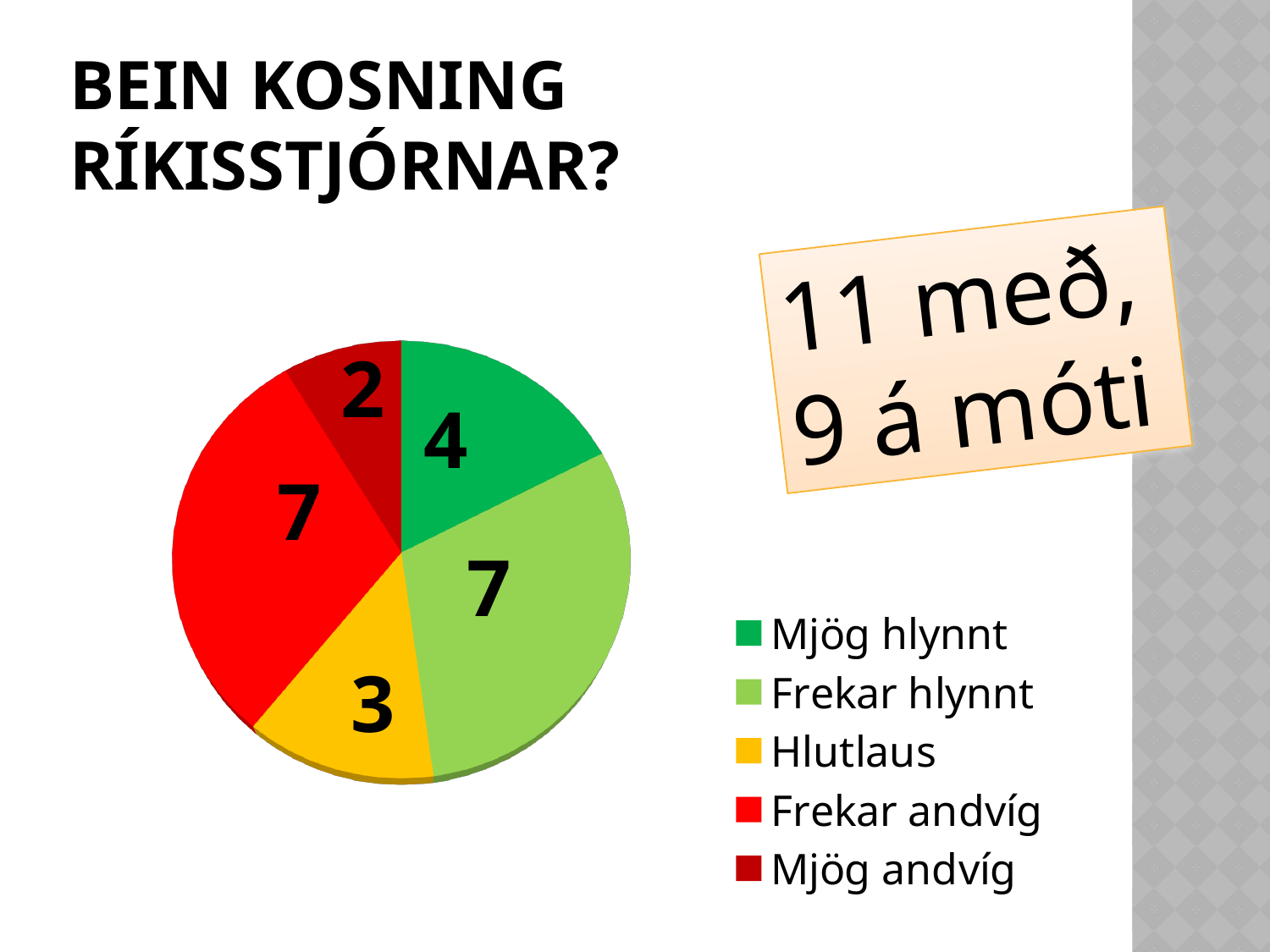
Which category has the smallest slice in the pie chart? Mjög andvíg How many slices does the pie chart have? 5 What kind of chart is shown on the slide? pie chart What is the difference between the values for Frekar hlynnt and Mjög hlynnt? 3 Which is larger, the value for Hlutlaus or the value for Mjög andvíg? Hlutlaus What colour is the Hlutlaus slice in the pie chart? yellow What is the value for Mjög hlynnt in the pie chart? 4 What is the value for Frekar hlynnt in the pie chart? 7 What is the value for Mjög andvíg in the pie chart? 2 What is the value for Hlutlaus in the pie chart? 3 How many entries does the legend list? 5 What is the total of all the values shown in the pie chart? 23